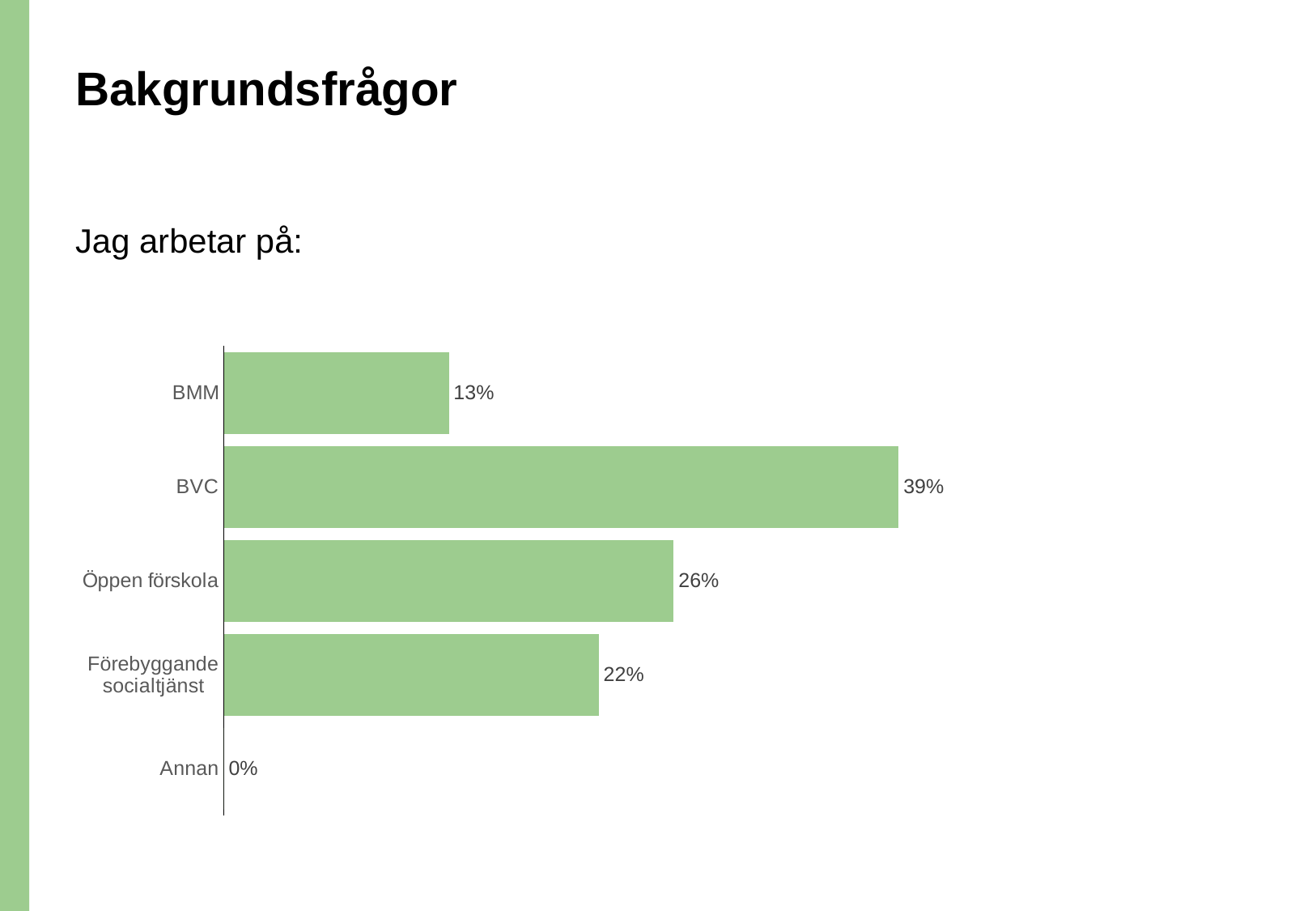
What is the value for BMM? 13% What is the value for Öppen förskola? 26% What kind of chart is shown on the slide? Bar chart Which category has the highest value? BVC What is the value for BVC? 39% How many categories are shown in the chart? 5 What is the value for Annan? 0% Which is larger, the value for Öppen förskola or the value for BMM? Öppen förskola What is the difference between the values for BVC and BMM? 26% Which category has the lowest value? Annan What is the value for Förebyggande socialtjänst? 22% What is the difference between the values for Öppen förskola and Förebyggande socialtjänst? 4%